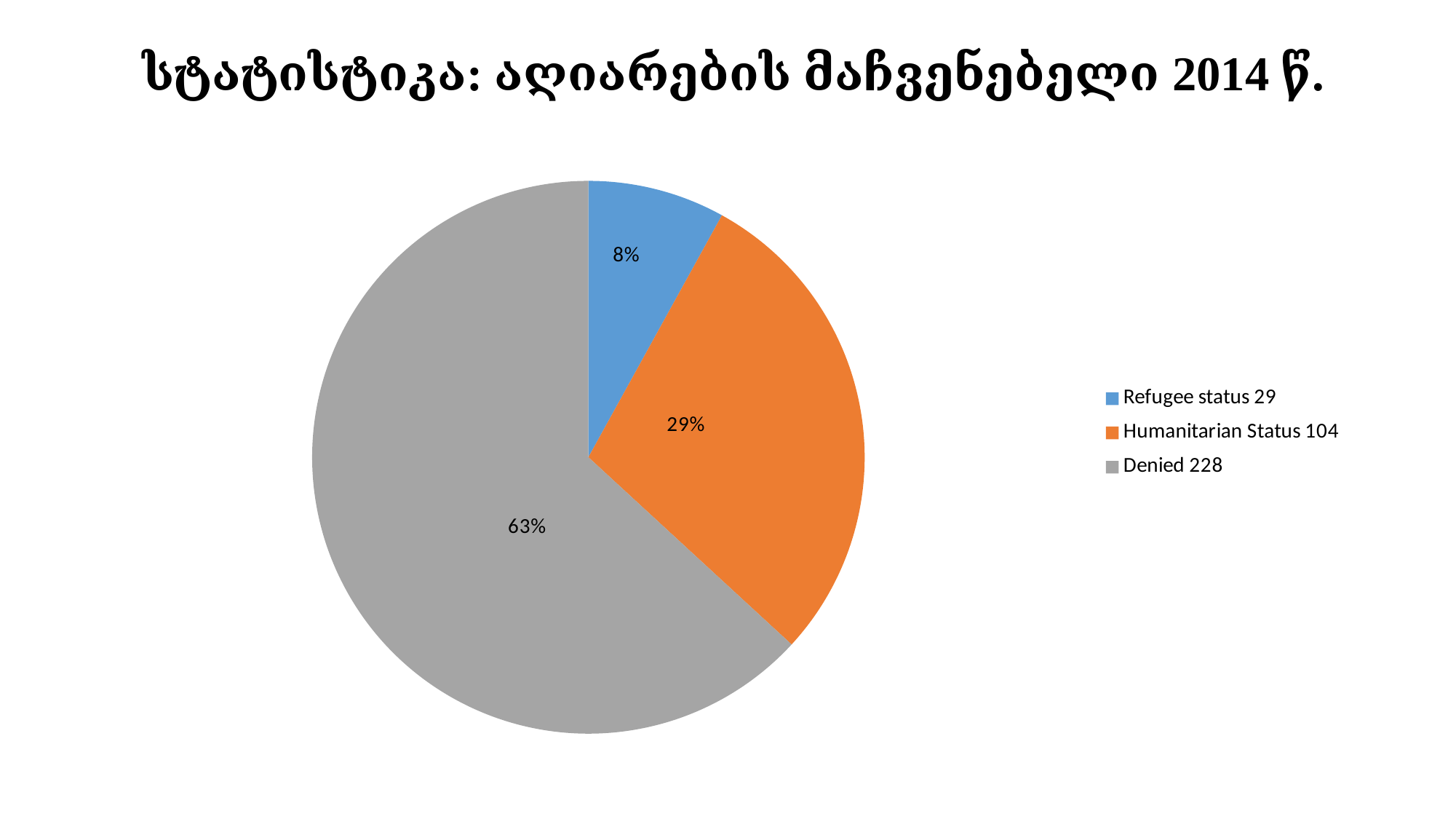
Which category has the smallest slice of the pie? Refugee status What percentage share does the Humanitarian Status slice have? 29% Which slice is larger, Humanitarian Status or Refugee status? Humanitarian Status How many slices does the pie chart have? 3 What kind of chart is shown on the slide? pie chart What is the difference in percentage points between the Denied share and the Humanitarian Status share? 34 What colour is the Denied slice? grey What number appears next to 'Humanitarian Status' in the legend? 104 What percentage share does the Denied slice have? 63% What percentage share does the Refugee status slice have? 8% Which category has the largest slice of the pie? Denied How many entries does the legend list? 3